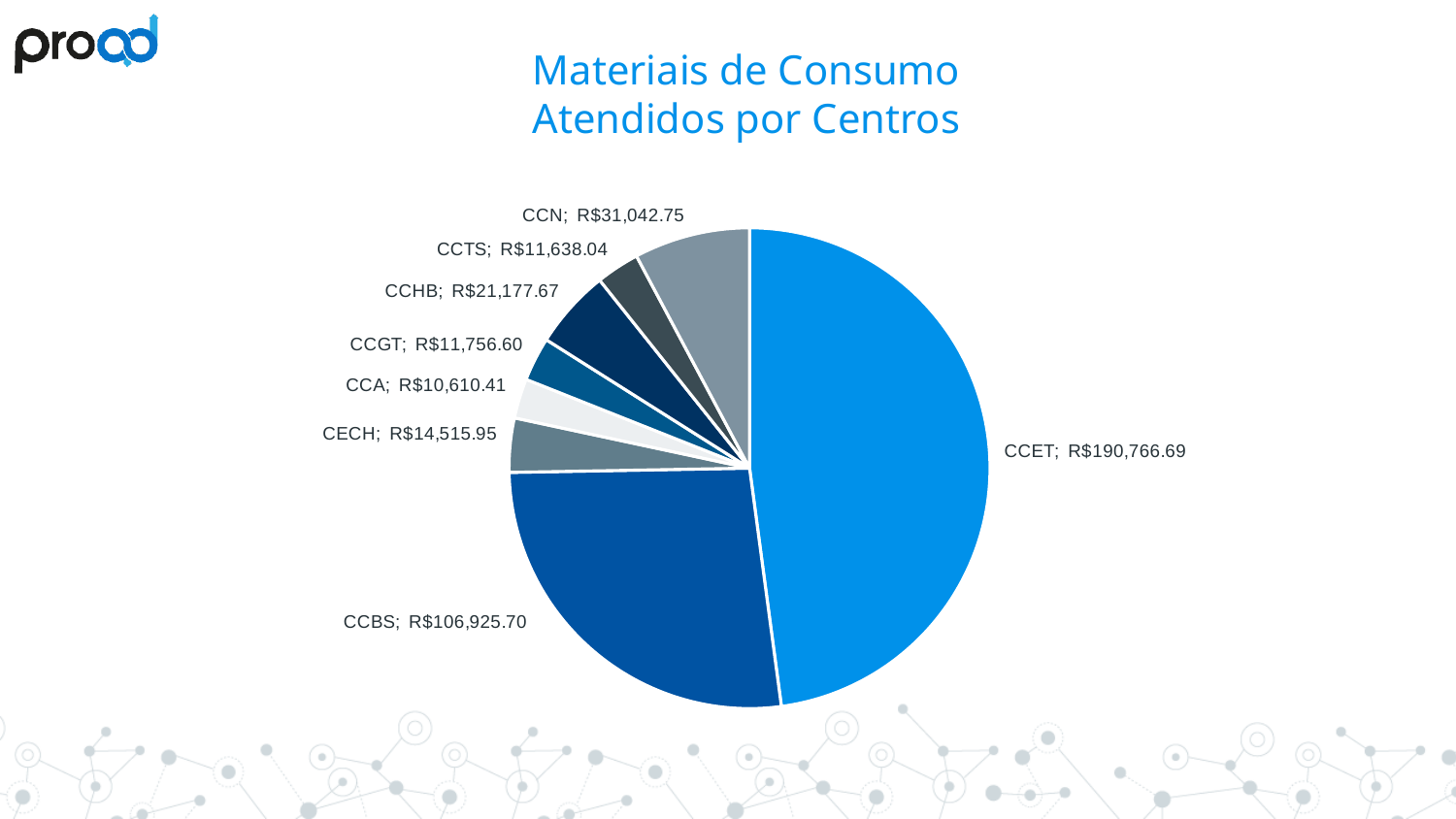
What is the value for CCET? R$190,766.69 How many centros (slices) are shown in the pie chart? 8 What is the title of the chart? Materiais de Consumo Atendidos por Centros What is the value for CCBS? R$106,925.70 Which is larger, the value for CCBS or the value for CCN? CCBS What is the value for CCHB? R$21,177.67 Which centro has the smallest value? CCA Which centro has the largest slice? CCET What is the value for CCN? R$31,042.75 What is the difference between the values for CCN and CCHB? R$9,865.08 What is the difference between the values for CCET and CCBS? R$83,840.99 What type of chart is shown on the slide? pie chart